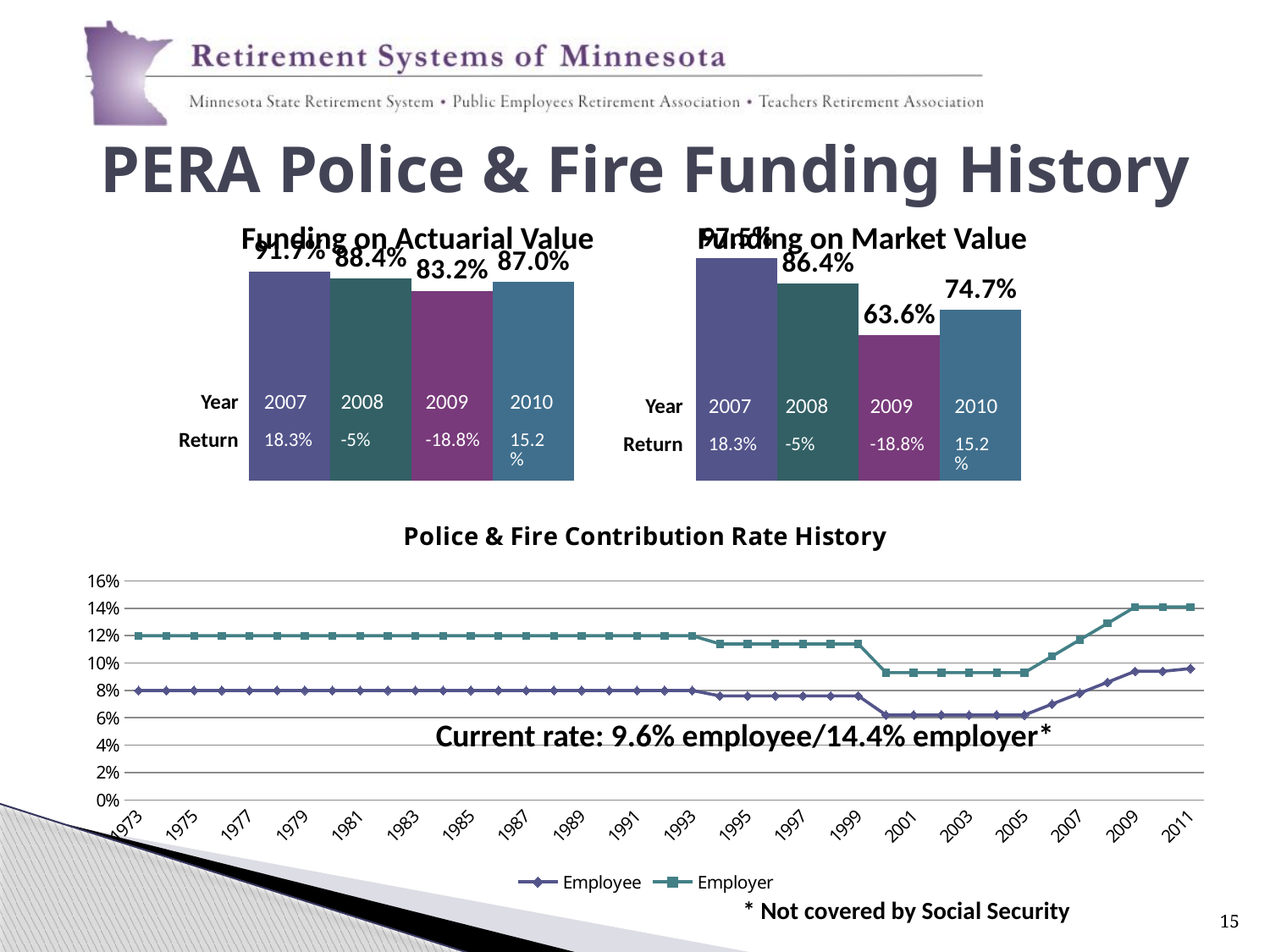
In the Funding on Actuarial Value chart, which year has the highest funding value? 2007 In the Funding on Market Value chart, which year has the lowest funding value? 2009 In the Funding on Market Value chart, what is the funding value for 2010? 74.7% In the Funding on Actuarial Value chart, what is the funding value for 2009? 83.2% In the Funding on Market Value chart, what is the difference between the 2008 and 2009 funding values? 22.8 percentage points What kind of chart is the Police & Fire Contribution Rate History chart? Line chart How many series does the legend of the Police & Fire Contribution Rate History chart list? 2 In the Police & Fire Contribution Rate History chart, does the Employee rate rise or fall from 2005 to 2011? rise How many bars are shown in the Funding on Actuarial Value chart? 4 In the Funding on Actuarial Value chart, which is larger, the 2008 value or the 2010 value? 2008 In the Police & Fire Contribution Rate History chart, is the Employer rate in 2003 greater or less than 10%? less In the Funding on Actuarial Value chart, what is the difference between the 2007 and 2008 funding values? 3.3 percentage points